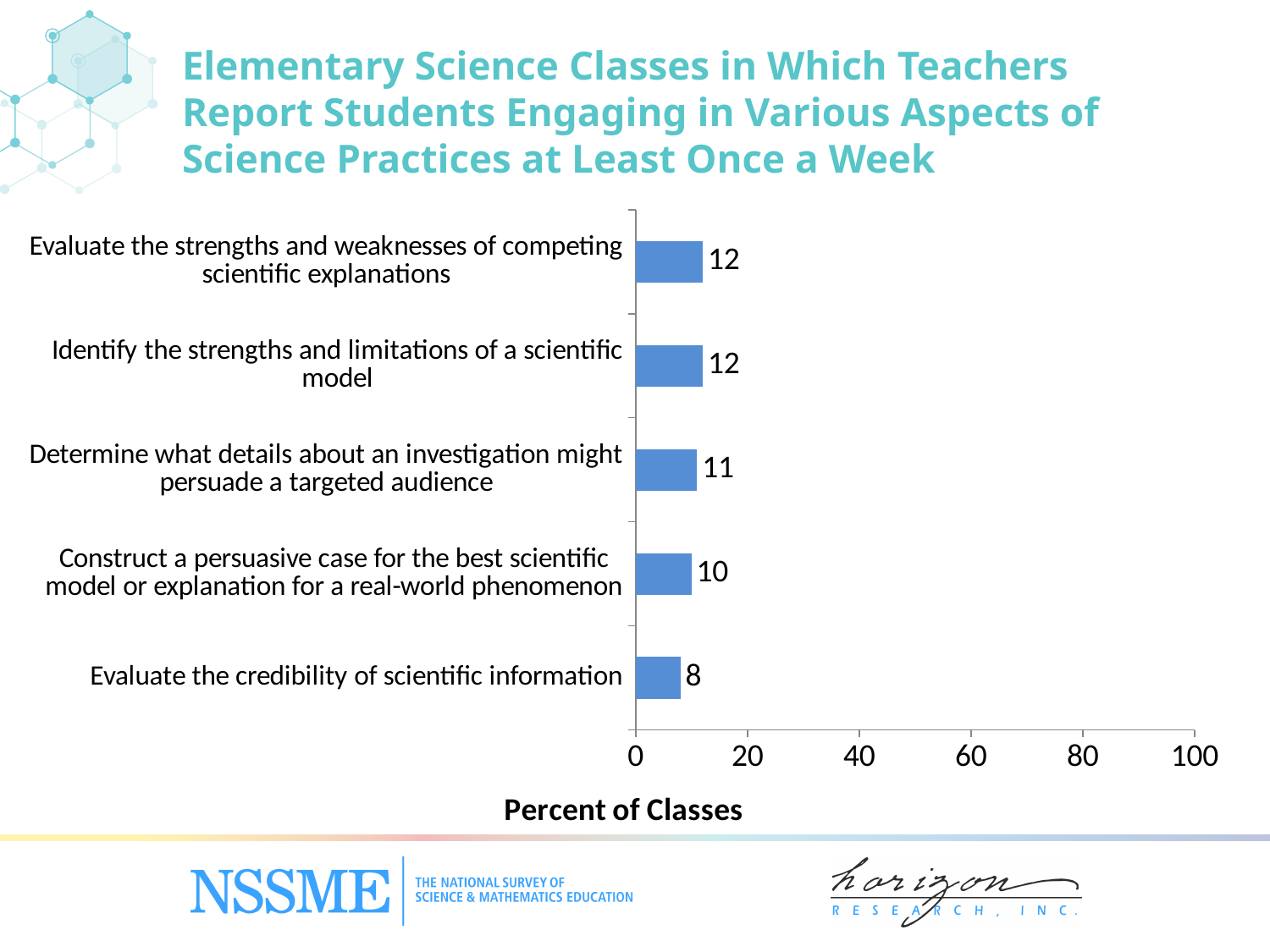
Which category has the lowest value? Evaluate the credibility of scientific information What percent of classes is reported for "Evaluate the credibility of scientific information"? 8 What is the value for "Identify the strengths and limitations of a scientific model"? 12 How many categories are shown in the chart? 5 What is the value for "Determine what details about an investigation might persuade a targeted audience"? 11 Is the value for "Identify the strengths and limitations of a scientific model" greater or less than 20? less What is the maximum value shown on the horizontal axis? 100 What is the label of the horizontal axis? Percent of Classes What is the difference between the values for "Evaluate the strengths and weaknesses of competing scientific explanations" and "Evaluate the credibility of scientific information"? 4 What is the value for "Construct a persuasive case for the best scientific model or explanation for a real-world phenomenon"? 10 What kind of chart is shown on the slide? bar chart Which is larger: the value for "Construct a persuasive case for the best scientific model or explanation for a real-world phenomenon" or for "Evaluate the credibility of scientific information"? Construct a persuasive case for the best scientific model or explanation for a real-world phenomenon